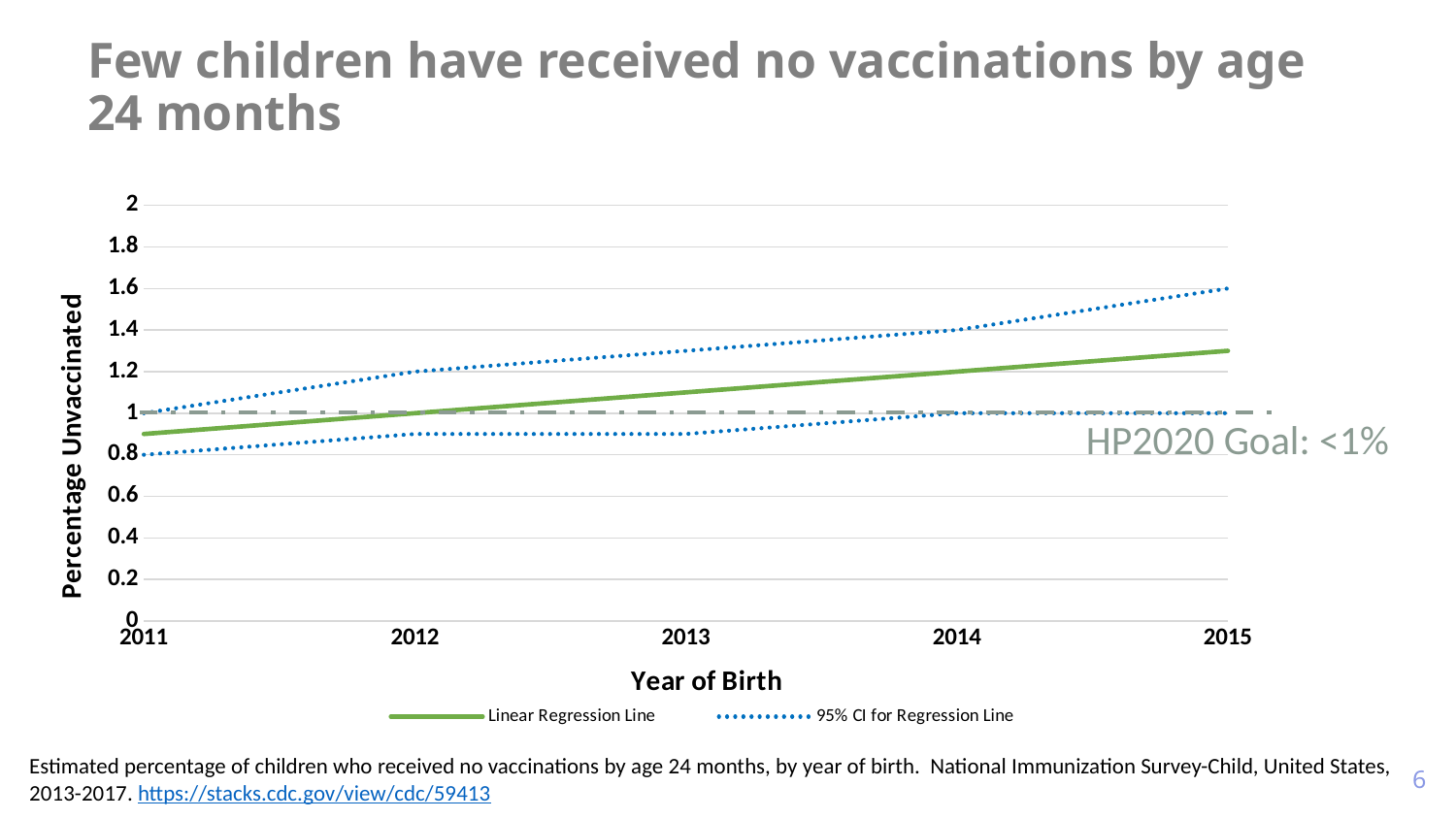
Is the value of the Linear Regression Line at 2015 greater or less than 1.2? greater Does the Linear Regression Line rise or fall from 2011 to 2015? rises Is the lower 95% CI for Regression Line at 2011 greater or less than 1? less What kind of chart is shown on the slide? line chart Is the upper 95% CI for Regression Line at 2015 greater or less than 1.4? greater How many series does the legend list? 2 How many years are labelled on the x axis? 5 What is the label of the y axis? Percentage Unvaccinated What goal is annotated on the chart by the dashed horizontal line? HP2020 Goal: <1% Is the Linear Regression Line value higher at 2015 or at 2011? 2015